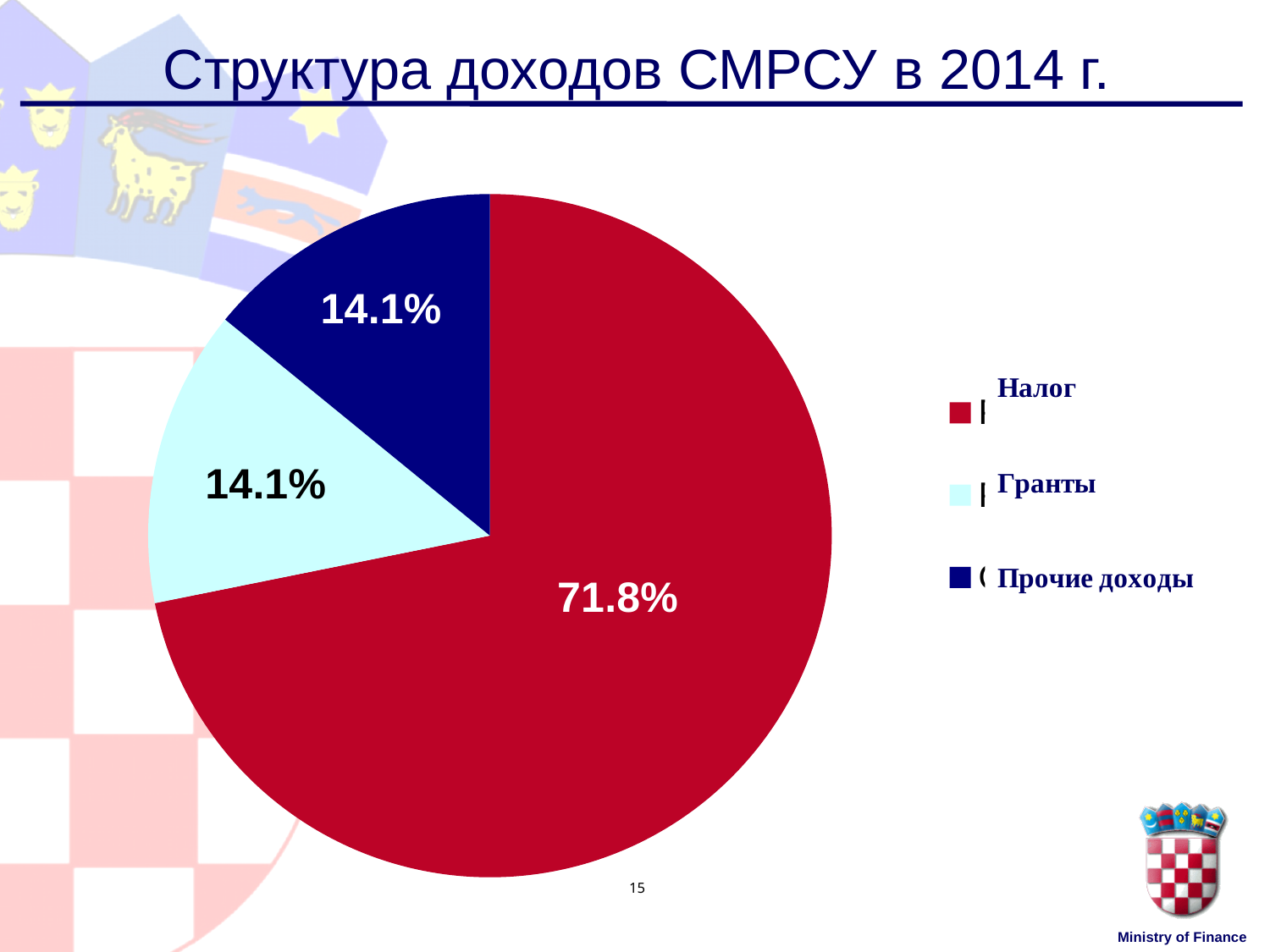
What share of the pie does Прочие доходы account for? 14.1% What is the difference between the share for Налог and the share for Прочие доходы? 57.7% Which is larger, the share for Налог or the share for Гранты? Налог How many entries does the legend list? 3 What kind of chart is shown on the slide? pie chart Is the share for Налог greater or less than 50%? greater How many slices does the pie chart have? 3 What share of the pie does Гранты account for? 14.1% What is the title of the chart? Структура доходов СМРСУ в 2014 г. What share of the pie does Налог account for? 71.8% Which category has the largest slice of the pie? Налог Which colour represents Прочие доходы in the legend? dark blue